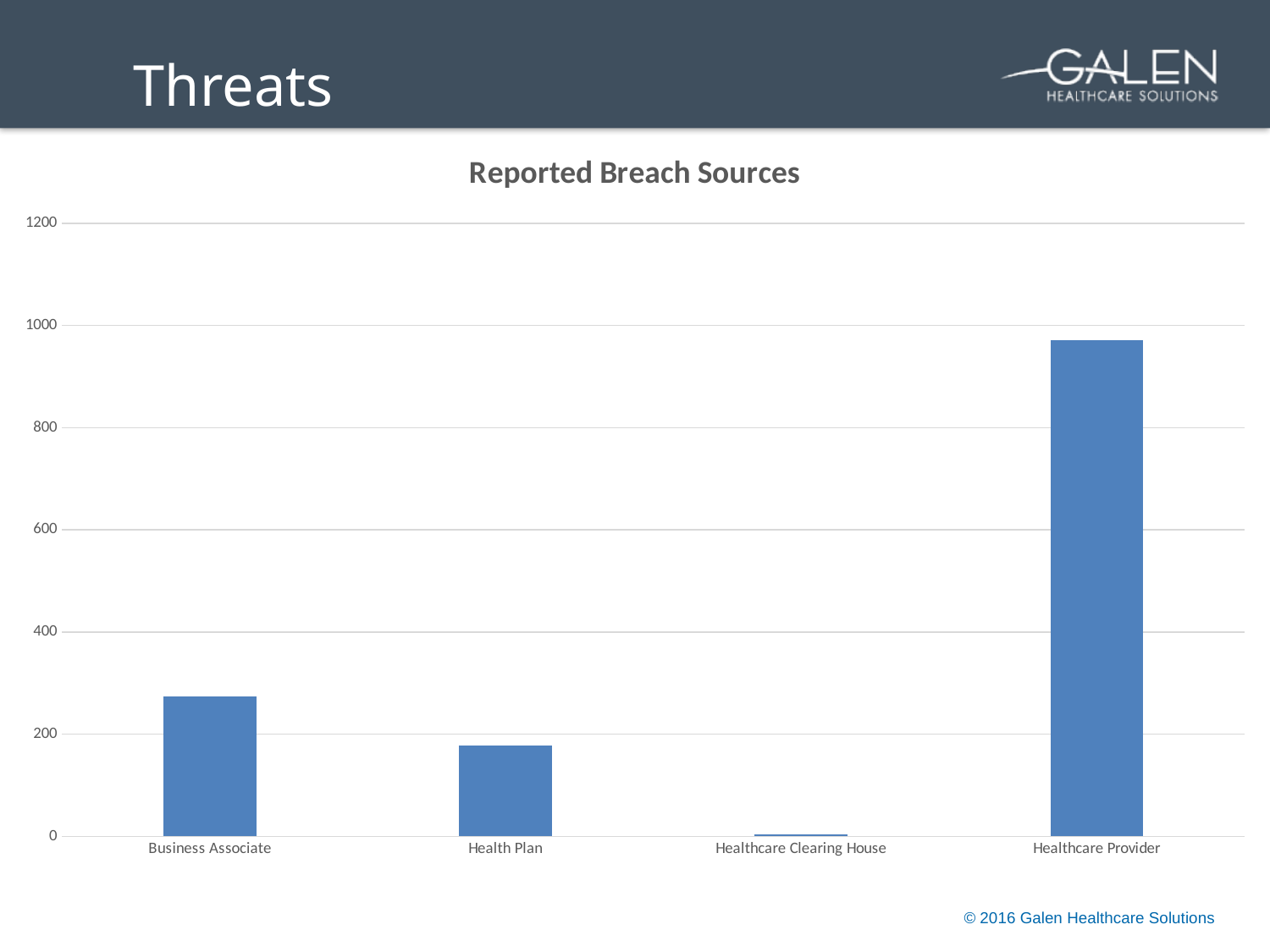
Is the value for Business Associate greater or less than 200? greater Which category has the lowest value in the chart? Healthcare Clearing House Which is larger, the value for Business Associate or the value for Health Plan? Business Associate What kind of chart is shown on the slide? bar chart Which category has the highest value in the chart? Healthcare Provider How many categories are shown on the x axis of the chart? 4 Is the value for Healthcare Provider greater or less than 800? greater Which is larger, the value for Health Plan or the value for Healthcare Clearing House? Health Plan Is the value for Health Plan greater or less than 200? less What is the title of the chart? Reported Breach Sources